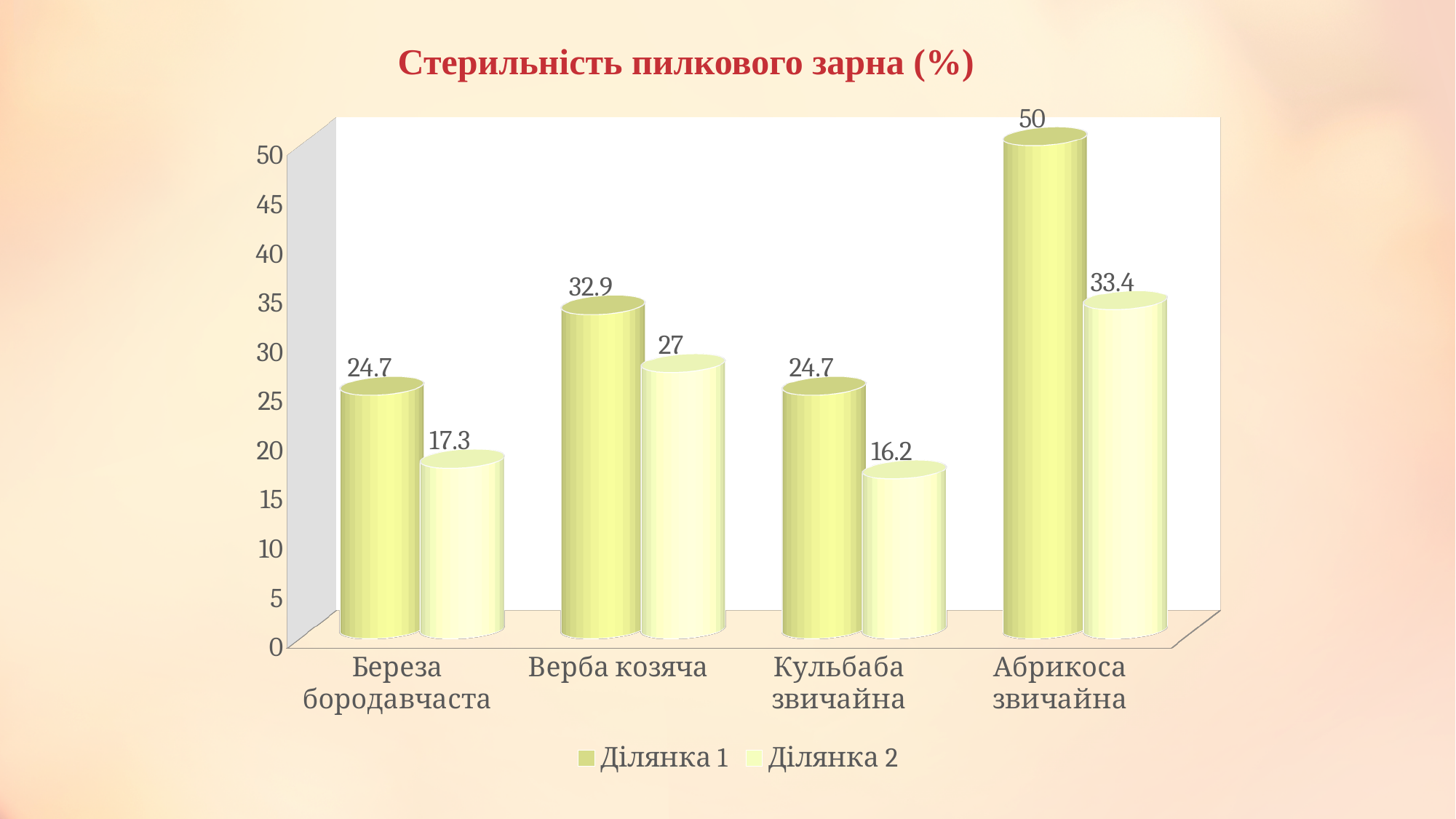
How many series does the legend list? 2 What is the value for Ділянка 2 for Береза бородавчаста? 17.3 What is the value for Ділянка 1 for Абрикоса звичайна? 50 What is the value for Ділянка 1 for Кульбаба звичайна? 24.7 What is the title of the chart? Стерильність пилкового зарна (%) What is the value for Ділянка 2 for Верба козяча? 27 How many categories are shown on the x axis? 4 What is the difference between Ділянка 1 and Ділянка 2 for Абрикоса звичайна? 16.6 Which category has the highest value for Ділянка 1? Абрикоса звичайна Which category has the lowest value for Ділянка 2? Кульбаба звичайна What kind of chart is shown on the slide? Bar chart Which is larger for Верба козяча: Ділянка 1 or Ділянка 2? Ділянка 1